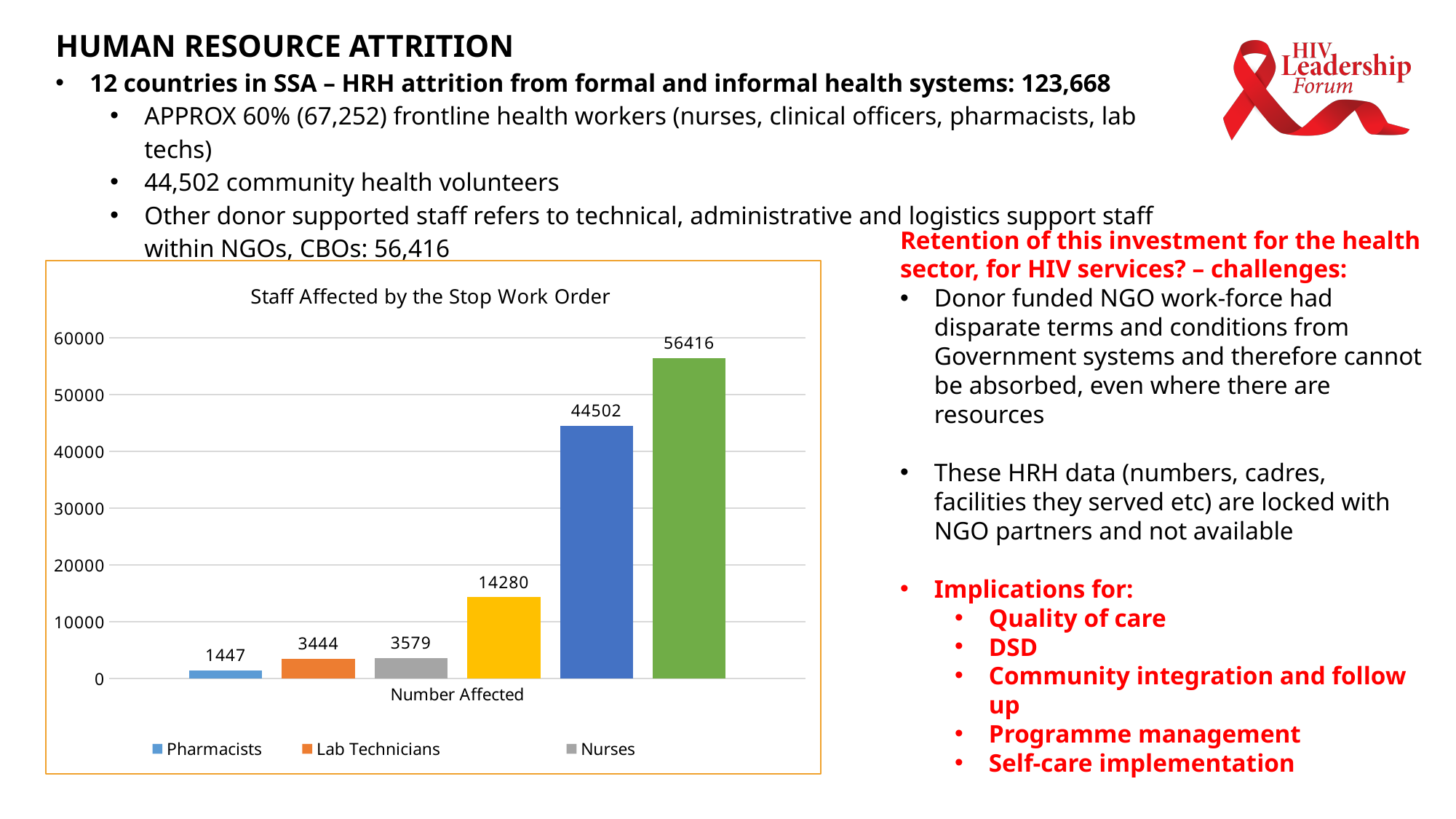
Which category has the lowest value in the chart? Pharmacists Is the value for Nurses greater or less than 10000? less What is the value for Pharmacists in the Staff Affected by the Stop Work Order chart? 1447 How many bars are plotted in the chart? 6 What is the highest value shown on any bar in the chart? 56416 What is the difference between the values for Lab Technicians and Pharmacists? 1997 What is the difference between the values for Nurses and Lab Technicians? 135 Which is larger, the value for Nurses or the value for Lab Technicians? Nurses What is the title of the chart? Staff Affected by the Stop Work Order What is the value for Lab Technicians in the chart? 3444 What is the value for Nurses in the chart? 3579 What kind of chart is shown on the slide? Bar chart